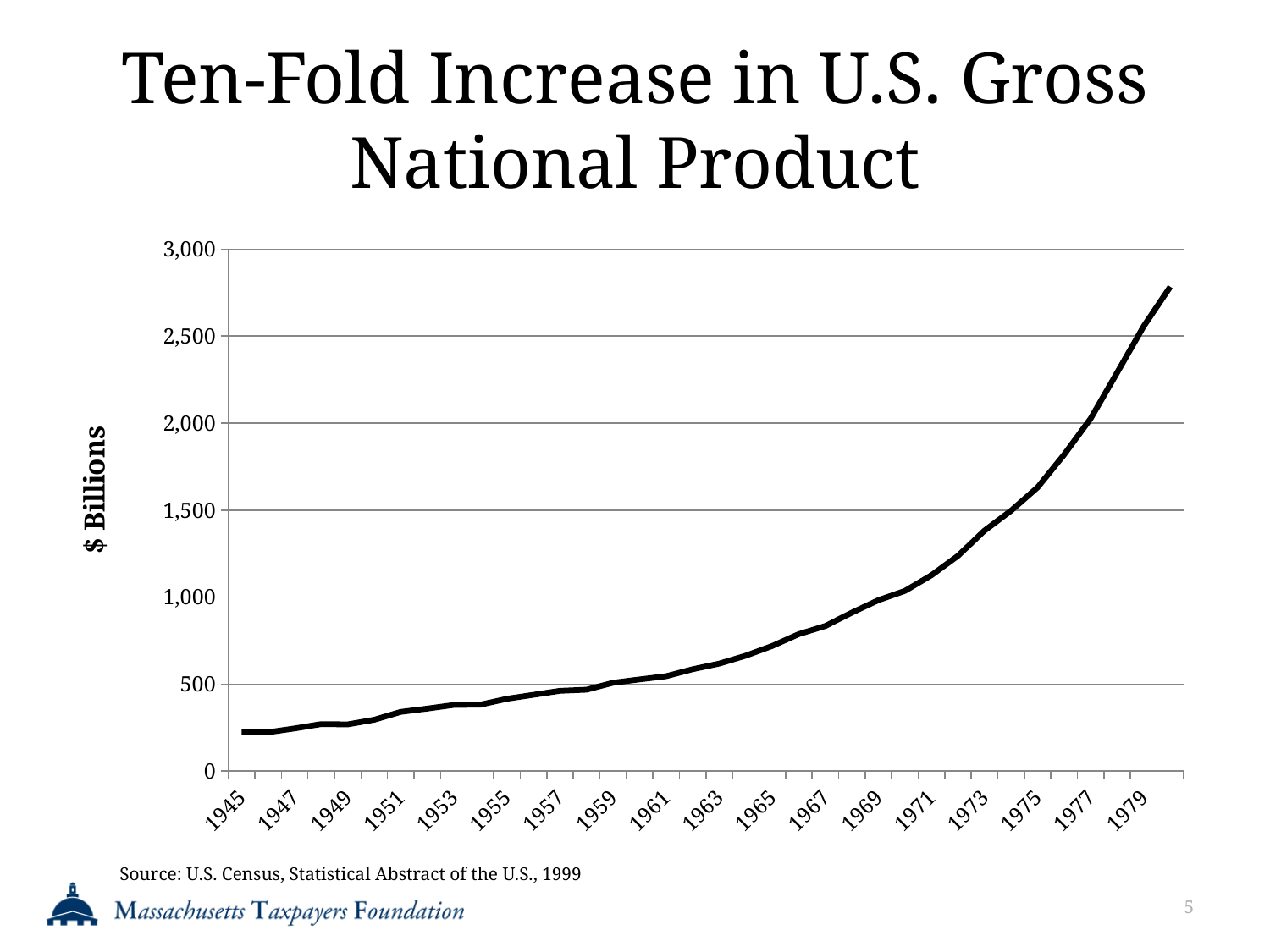
Does U.S. Gross National Product rise or fall from 1945 to the end of the period shown? rise Is the value for 1973 greater or less than 1,500? less Which year shown on the x axis has the lowest Gross National Product value? 1945 Is the value for 1955 greater or less than 500? less Which year has the larger Gross National Product value, 1951 or 1971? 1971 Is the value for 1945 greater or less than 500? less What kind of chart is shown on the slide? line chart What is the title of the chart on the slide? Ten-Fold Increase in U.S. Gross National Product What is the label on the vertical axis of the chart? $ Billions